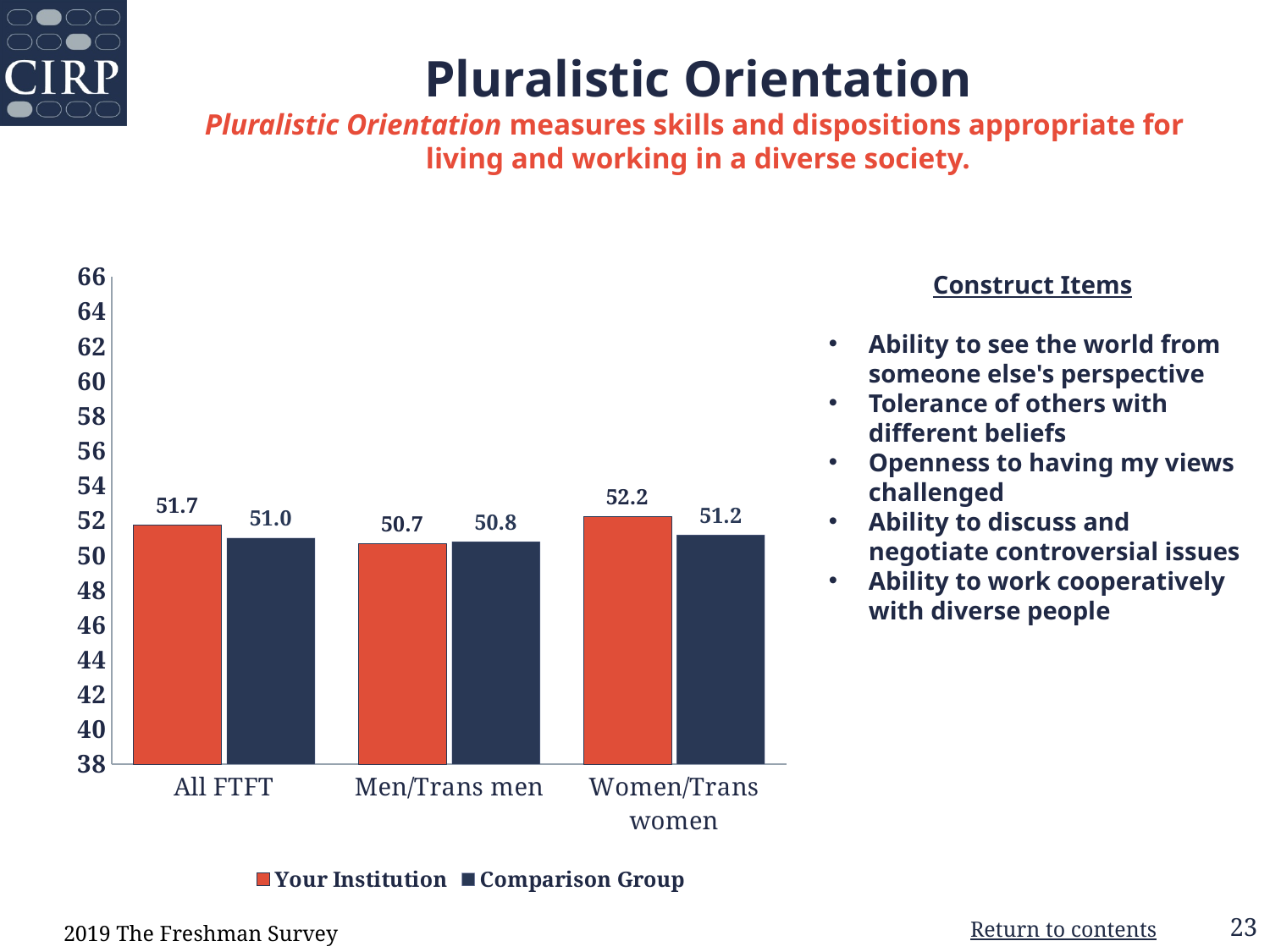
What kind of chart is shown on the slide? Bar chart Which category has the lowest Comparison Group value? Men/Trans men What is the difference between the Your Institution values for Women/Trans women and Men/Trans men? 1.5 What is the Your Institution value for All FTFT? 51.7 Which is larger for Women/Trans women: Your Institution or Comparison Group? Your Institution Which category has the highest Your Institution value? Women/Trans women What is the Comparison Group value for Men/Trans men? 50.8 What is the Comparison Group value for Women/Trans women? 51.2 How many series does the legend list? 2 What is the difference between the Your Institution and Comparison Group values for All FTFT? 0.7 How many categories are shown on the x axis? 3 What is the Your Institution value for Men/Trans men? 50.7